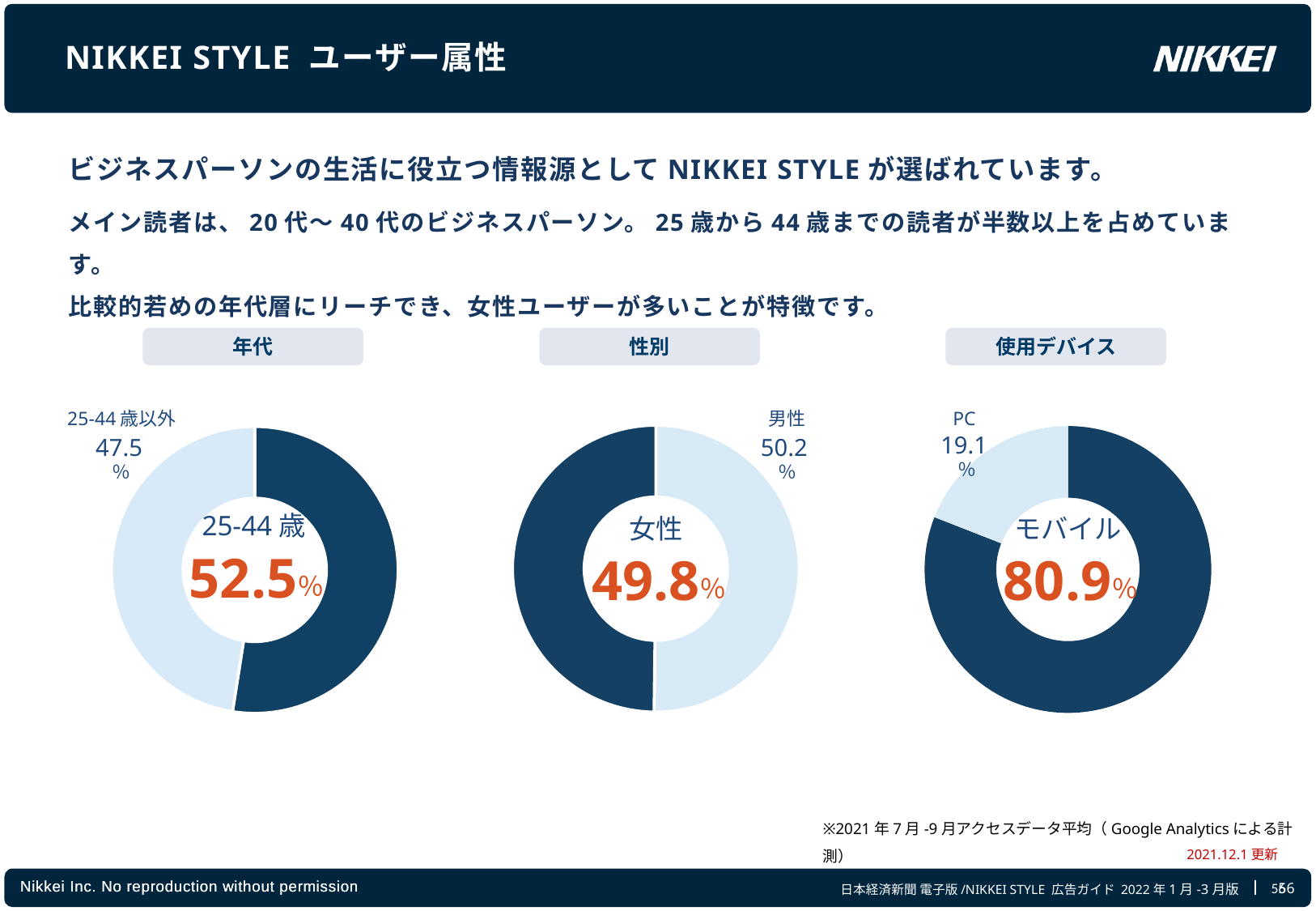
In the 年代 chart, what share of users are 25-44 歳? 52.5% In the 使用デバイス chart, what is the difference between モバイル and PC? 61.8% In the 使用デバイス chart, what is the value for モバイル? 80.9% In the 年代 chart, what share of users are 25-44 歳以外? 47.5% How many charts are shown on the slide? 3 In the 使用デバイス chart, what is the value for PC? 19.1% In the 使用デバイス chart, which segment is the largest? モバイル In the 性別 chart, what is the value for 女性? 49.8% How many segments does the 年代 chart have? 2 In the 性別 chart, what is the value for 男性? 50.2% In the 年代 chart, what is the difference between 25-44 歳 and 25-44 歳以外? 5.0% What kind of chart is used for the 性別 data? Donut (pie) chart